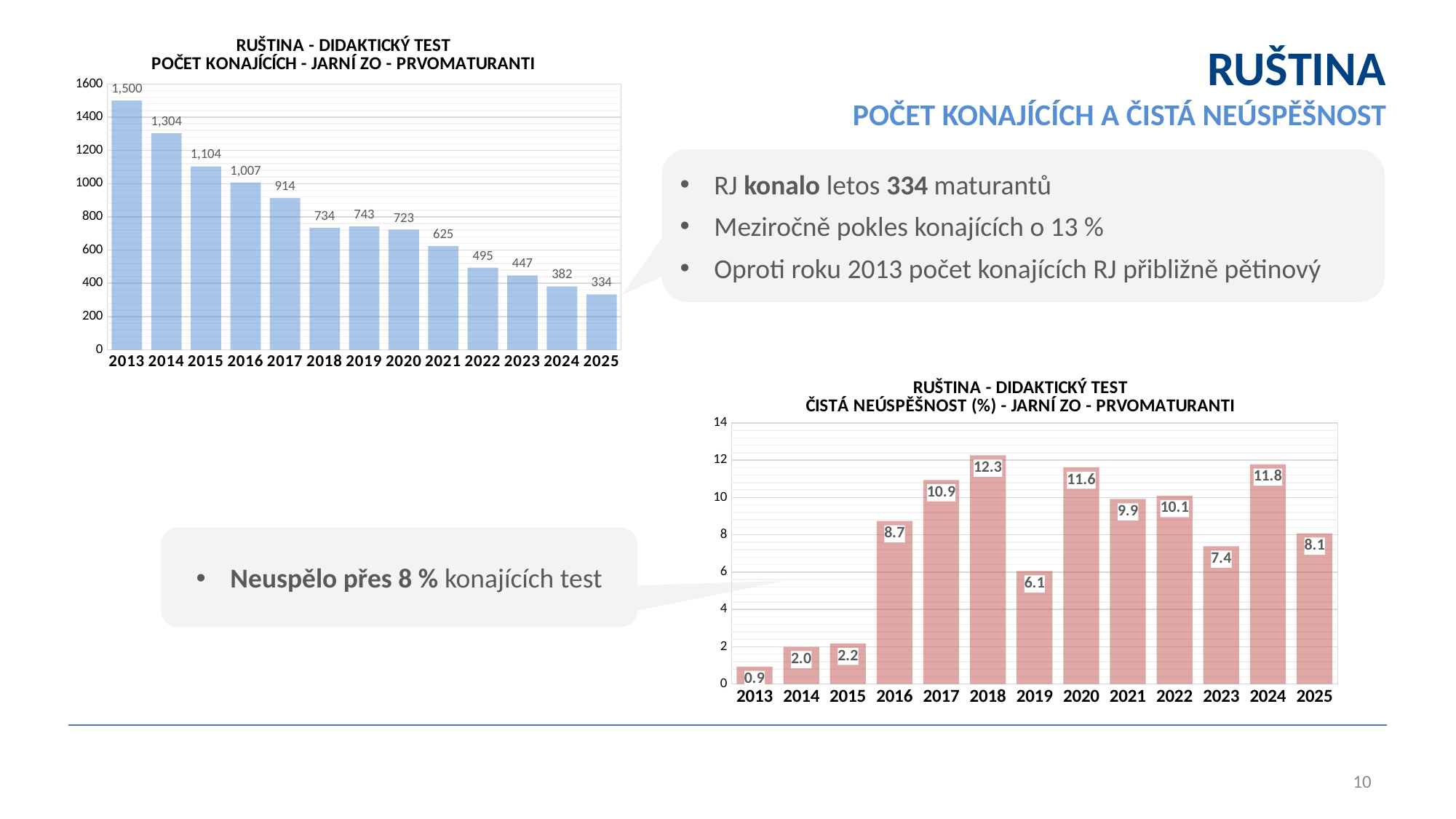
What kind of chart is the chart 'ČISTÁ NEÚSPĚŠNOST (%) - JARNÍ ZO - PRVOMATURANTI' (bottom right)? bar chart In the chart 'POČET KONAJÍCÍCH - JARNÍ ZO - PRVOMATURANTI' (top left), what is the value for 2013? 1,500 In the chart 'POČET KONAJÍCÍCH - JARNÍ ZO - PRVOMATURANTI' (top left), what is the difference between the values for 2024 and 2025? 48 In the chart 'ČISTÁ NEÚSPĚŠNOST (%) - JARNÍ ZO - PRVOMATURANTI' (bottom right), which year has the lowest value? 2013 How many years are shown on the x axis of the chart 'POČET KONAJÍCÍCH - JARNÍ ZO - PRVOMATURANTI' (top left)? 13 In the chart 'ČISTÁ NEÚSPĚŠNOST (%) - JARNÍ ZO - PRVOMATURANTI' (bottom right), which year has the highest value? 2018 In the chart 'ČISTÁ NEÚSPĚŠNOST (%) - JARNÍ ZO - PRVOMATURANTI' (bottom right), what is the difference between the values for 2024 and 2025? 3.7 In the chart 'ČISTÁ NEÚSPĚŠNOST (%) - JARNÍ ZO - PRVOMATURANTI' (bottom right), what is the value for 2018? 12.3 In the chart 'POČET KONAJÍCÍCH - JARNÍ ZO - PRVOMATURANTI' (top left), which year has the lowest value? 2025 In the chart 'POČET KONAJÍCÍCH - JARNÍ ZO - PRVOMATURANTI' (top left), do the values generally rise or fall from 2013 to 2025? fall In the chart 'POČET KONAJÍCÍCH - JARNÍ ZO - PRVOMATURANTI' (top left), which is larger, the value for 2018 or 2019? 2019 In the chart 'POČET KONAJÍCÍCH - JARNÍ ZO - PRVOMATURANTI' (top left), what is the value for 2025? 334